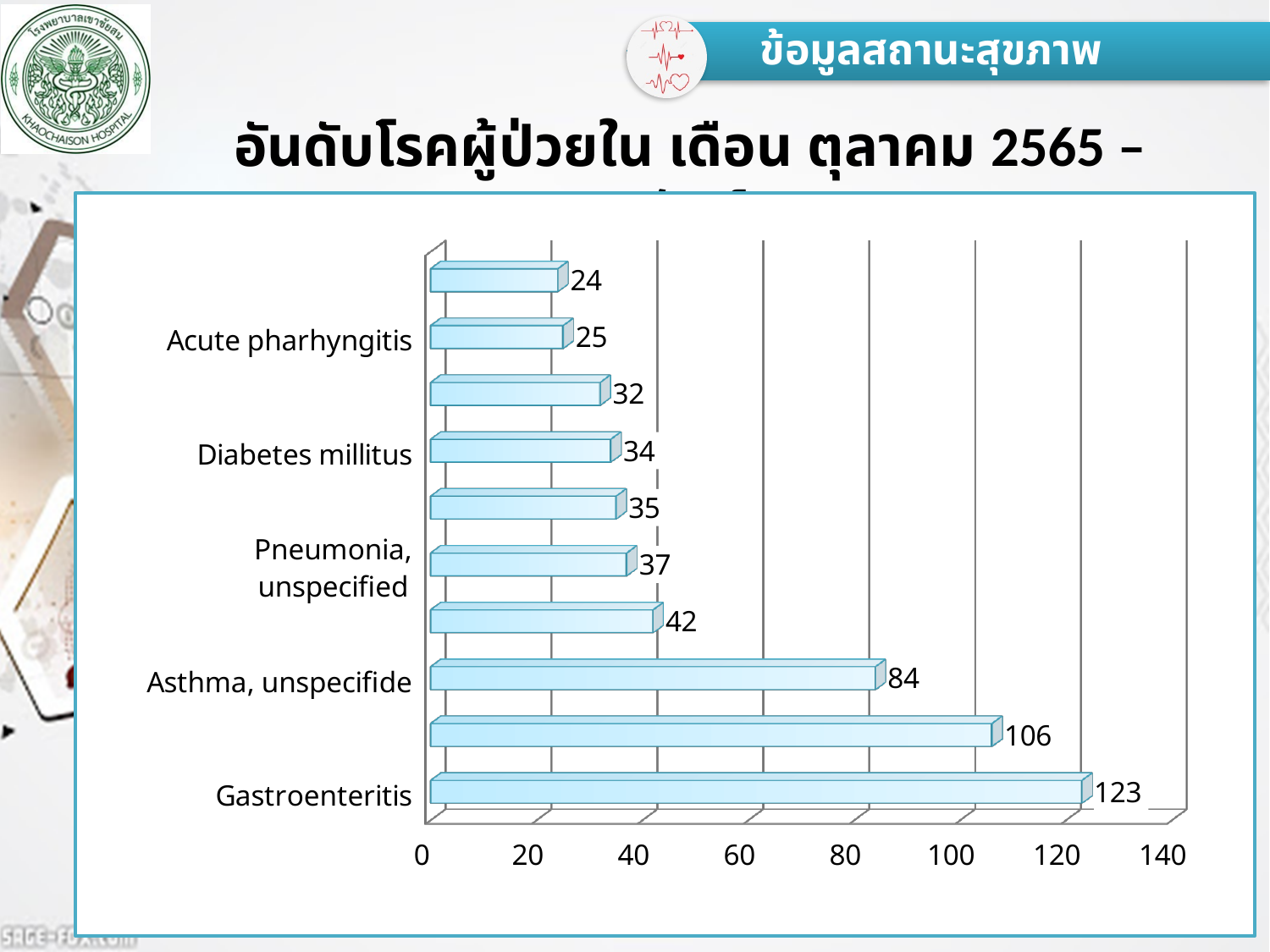
What kind of chart is shown on the slide? bar chart What is the value for Acute pharhyngitis? 25 What is the value for Pneumonia, unspecified? 37 What is the difference between the values for Gastroenteritis and Asthma, unspecifide? 39 Which category has the highest value? Gastroenteritis Is the value for Asthma, unspecifide greater or less than 100? less Which is larger, the value for Diabetes millitus or the value for Pneumonia, unspecified? Pneumonia, unspecified What is the value for Diabetes millitus? 34 What is the smallest value shown on the chart? 24 What is the value for Asthma, unspecifide? 84 What is the value for Gastroenteritis? 123 How many bars are plotted on the chart? 10